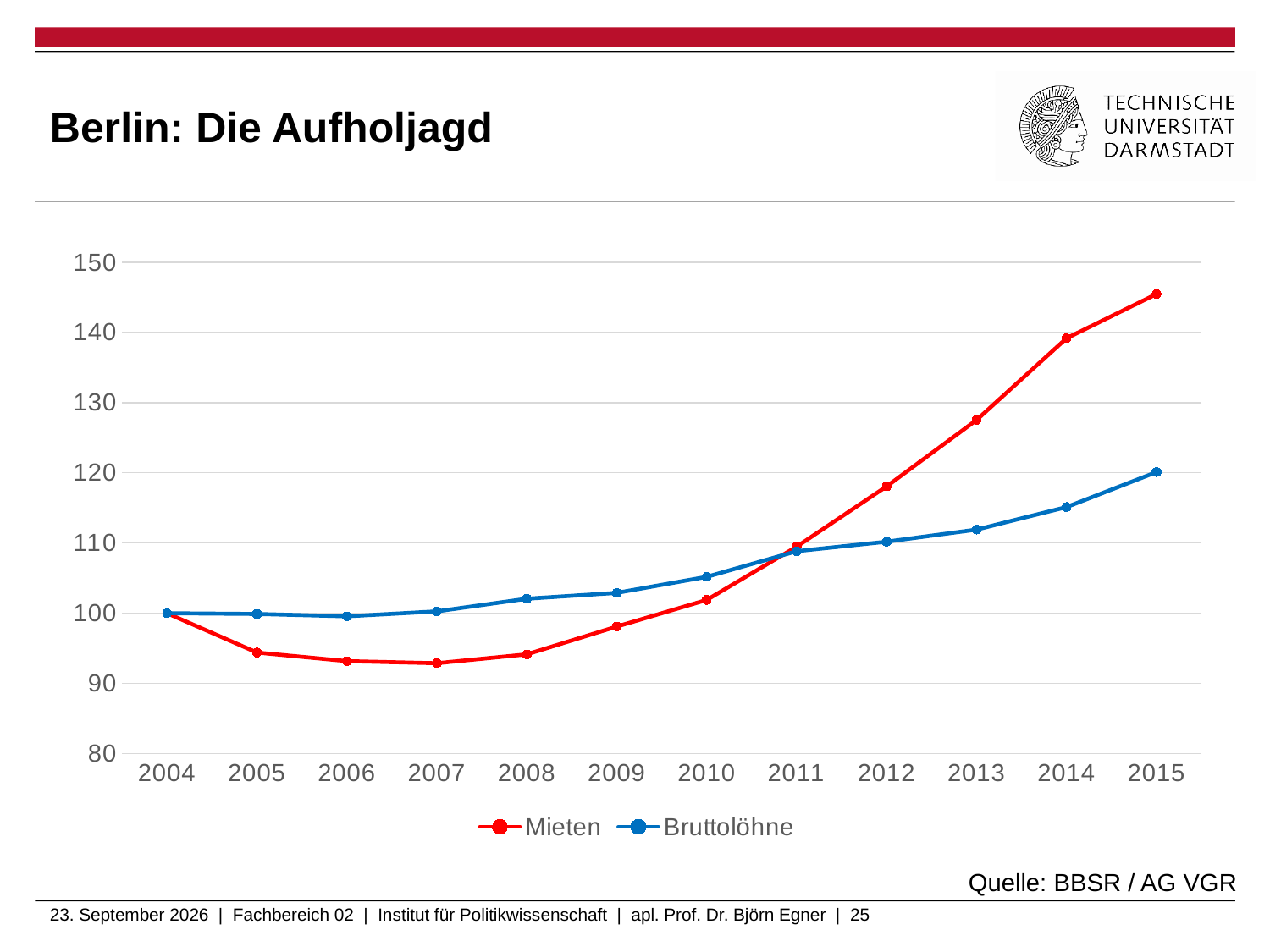
Is the value for Mieten in 2015 greater or less than 140? greater What is the value for Mieten in 2004? 100 What kind of chart is shown on the slide? line chart What is the value for Bruttolöhne in 2004? 100 Is the value for Mieten in 2007 greater or less than 100? less How many years are plotted along the x axis? 12 How many series does the legend list? 2 In 2014, which series has the higher value, Mieten or Bruttolöhne? Mieten In which year does the Mieten series reach its highest value? 2015 In 2008, which series has the higher value, Mieten or Bruttolöhne? Bruttolöhne Is the value for Bruttolöhne in 2013 greater or less than 110? greater What is the title of the slide containing the chart? Berlin: Die Aufholjagd